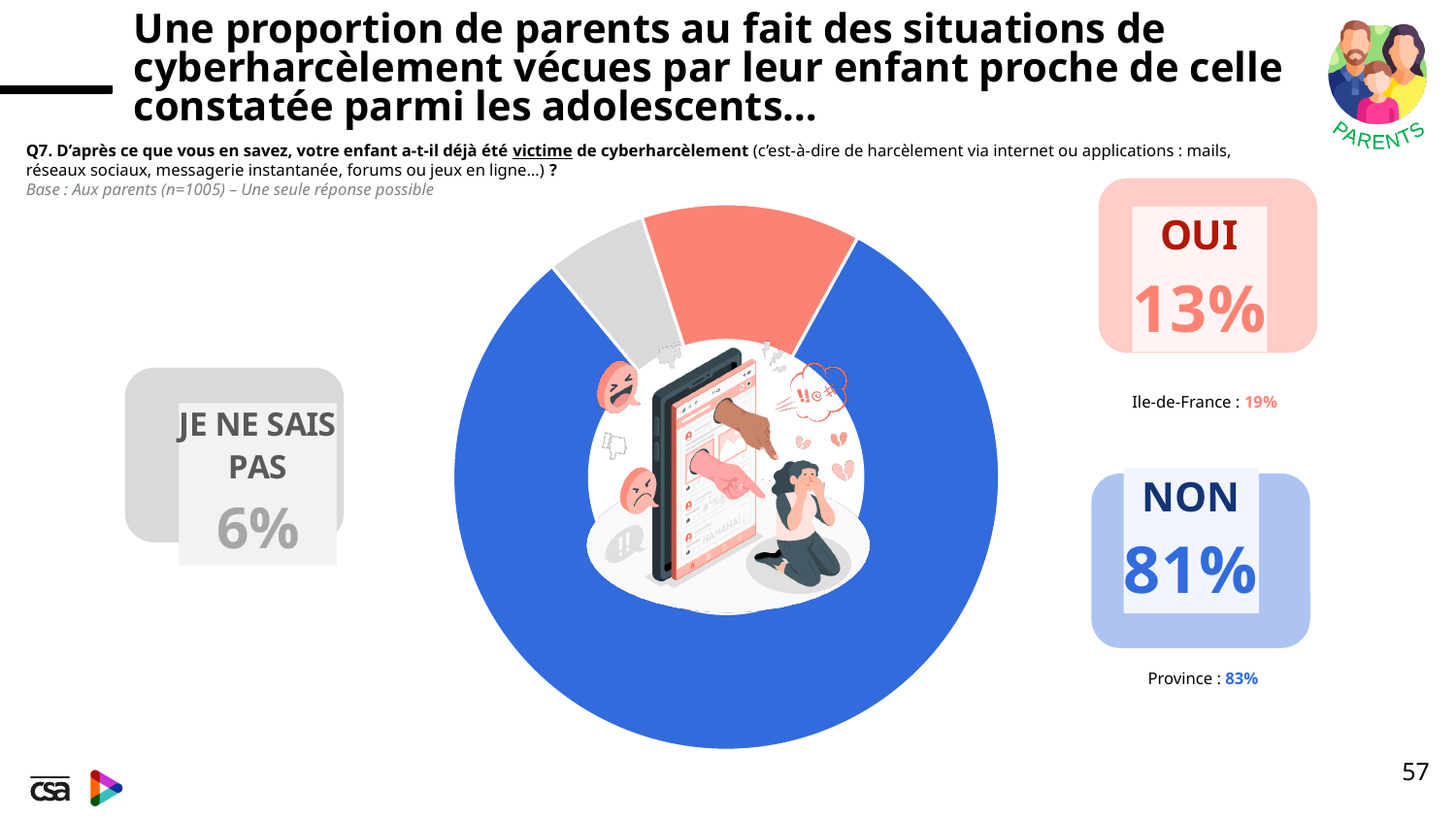
What percentage of parents answered "OUI" (yes) to whether their child has been a victim of cyberbullying? 13% What is the difference in percentage points between the "NON" and "OUI" shares? 68 What is the "OUI" percentage reported for Ile-de-France? 19% What is the "NON" percentage reported for Province? 83% What percentage of parents answered "NON"? 81% Which answer has the smallest share of the pie? JE NE SAIS PAS What colour is the "NON" slice of the pie chart? blue Which answer has the largest share of the pie? NON What percentage of parents answered "JE NE SAIS PAS"? 6% How many slices does the pie chart have? 3 What kind of chart is shown on the slide? doughnut chart Which is larger, the share for "OUI" or the share for "JE NE SAIS PAS"? OUI